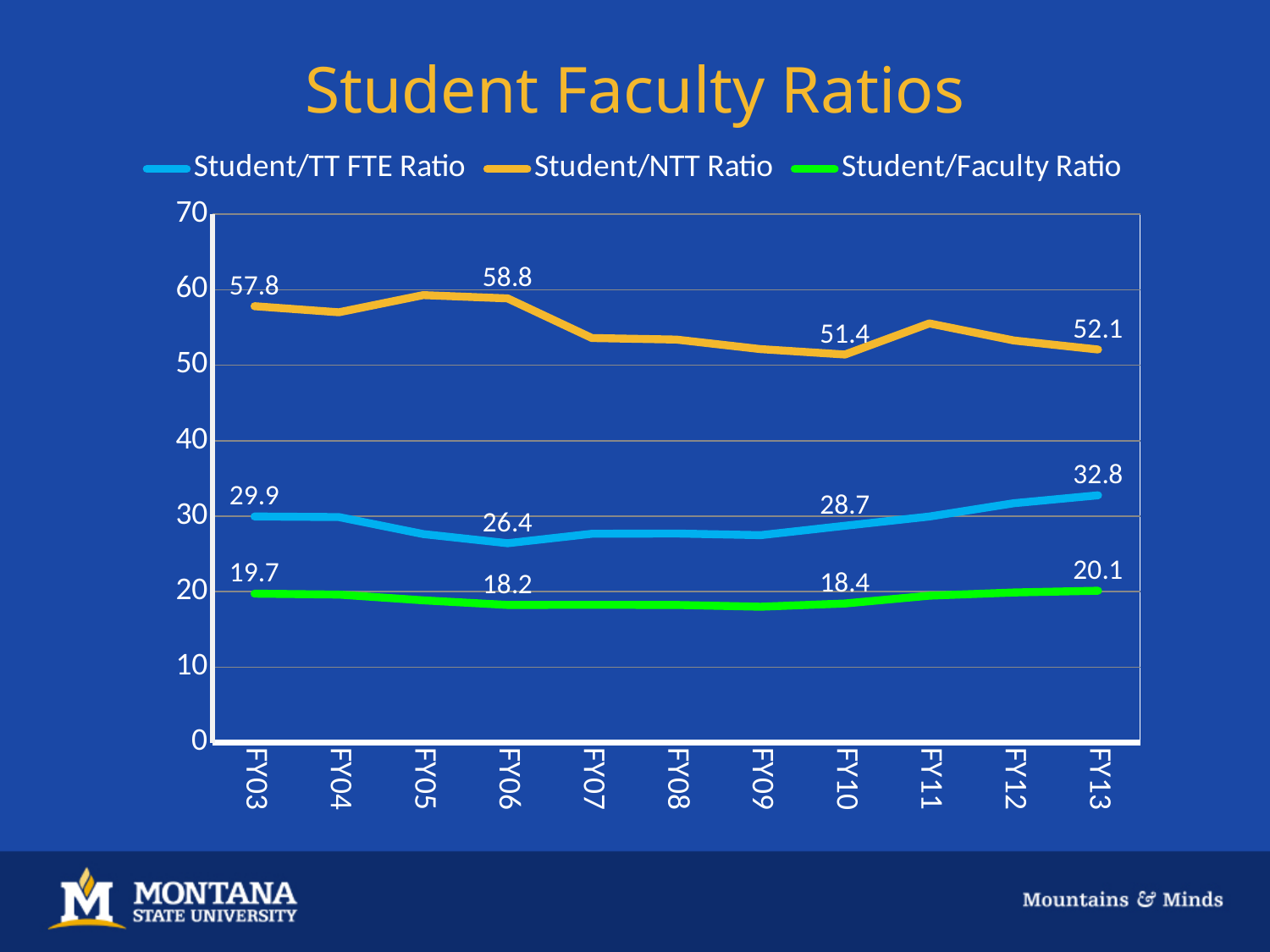
Is the Student/NTT Ratio in FY05 greater or less than 50? greater How many fiscal years are shown on the x axis? 11 How many series does the legend list? 3 What is the Student/Faculty Ratio in FY03? 19.7 What is the difference between the Student/NTT Ratio in FY06 and in FY10? 7.4 What is the Student/TT FTE Ratio in FY13? 32.8 Which is larger, the Student/NTT Ratio in FY03 or in FY13? FY03 What kind of chart is shown on the slide? line chart Which series has the highest values across all fiscal years? Student/NTT Ratio Does the Student/TT FTE Ratio rise or fall from FY09 to FY13? rise What is the Student/NTT Ratio in FY06? 58.8 By how much did the Student/TT FTE Ratio change from FY03 (29.9) to FY13 (32.8)? 2.9